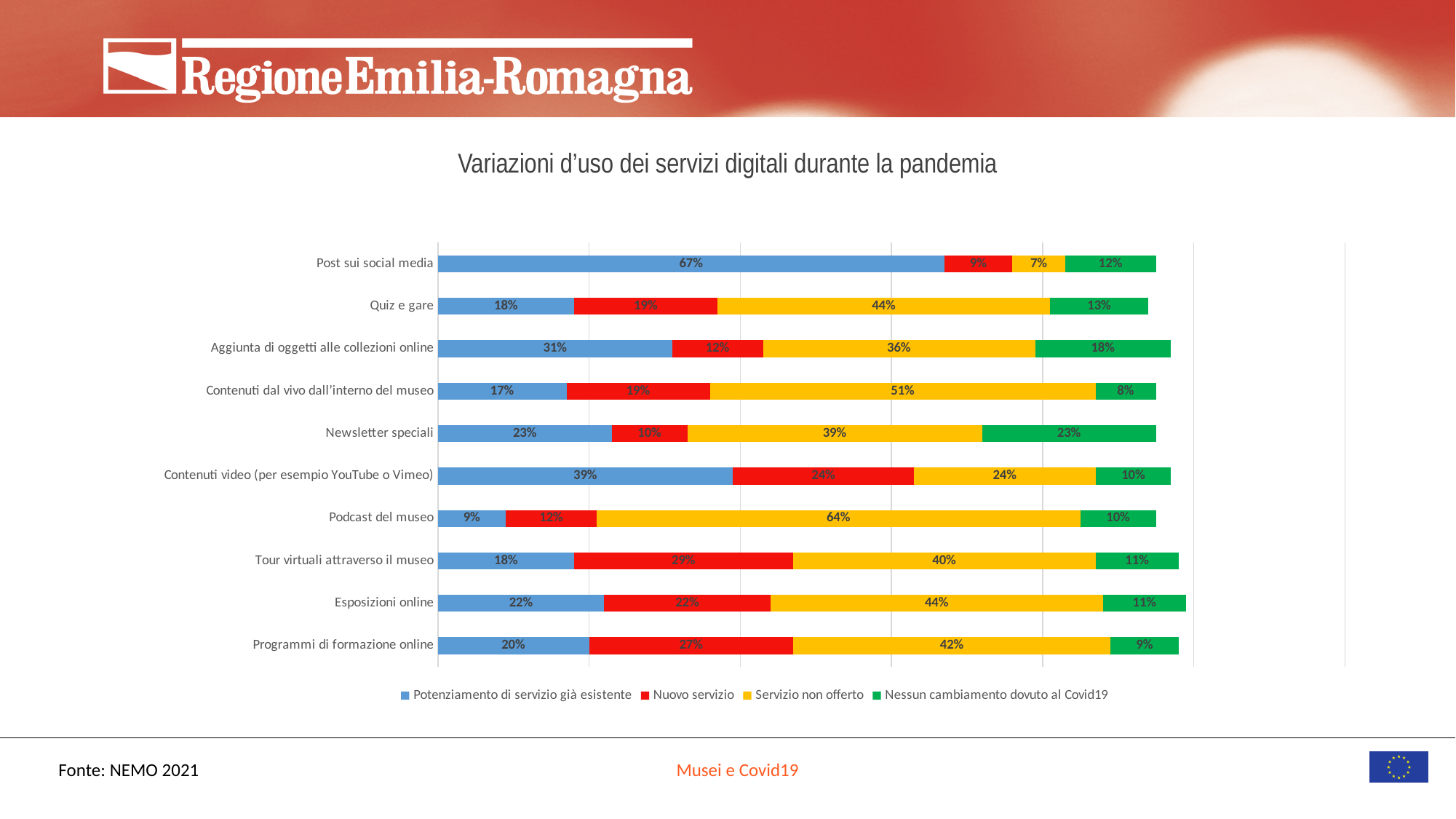
What is the difference between the 'Servizio non offerto' values for 'Podcast del museo' and 'Newsletter speciali'? 25% What is the value of 'Potenziamento di servizio già esistente' for 'Post sui social media'? 67% What is the total of the stacked bar for 'Quiz e gare'? 94% What is the value of 'Servizio non offerto' for 'Podcast del museo'? 64% What is the title of the chart? Variazioni d'uso dei servizi digitali durante la pandemia How many categories (digital services) are plotted on the chart? 10 Which is larger: the 'Nuovo servizio' value for 'Contenuti video (per esempio YouTube o Vimeo)' or for 'Esposizioni online'? Contenuti video (per esempio YouTube o Vimeo) Which category has the lowest value for 'Nessun cambiamento dovuto al Covid19'? Contenuti dal vivo dall'interno del museo What is the value of 'Nuovo servizio' for 'Tour virtuali attraverso il museo'? 29% Which category has the highest value for 'Potenziamento di servizio già esistente'? Post sui social media What kind of chart is shown on the slide? Stacked bar chart How many series does the legend list? 4